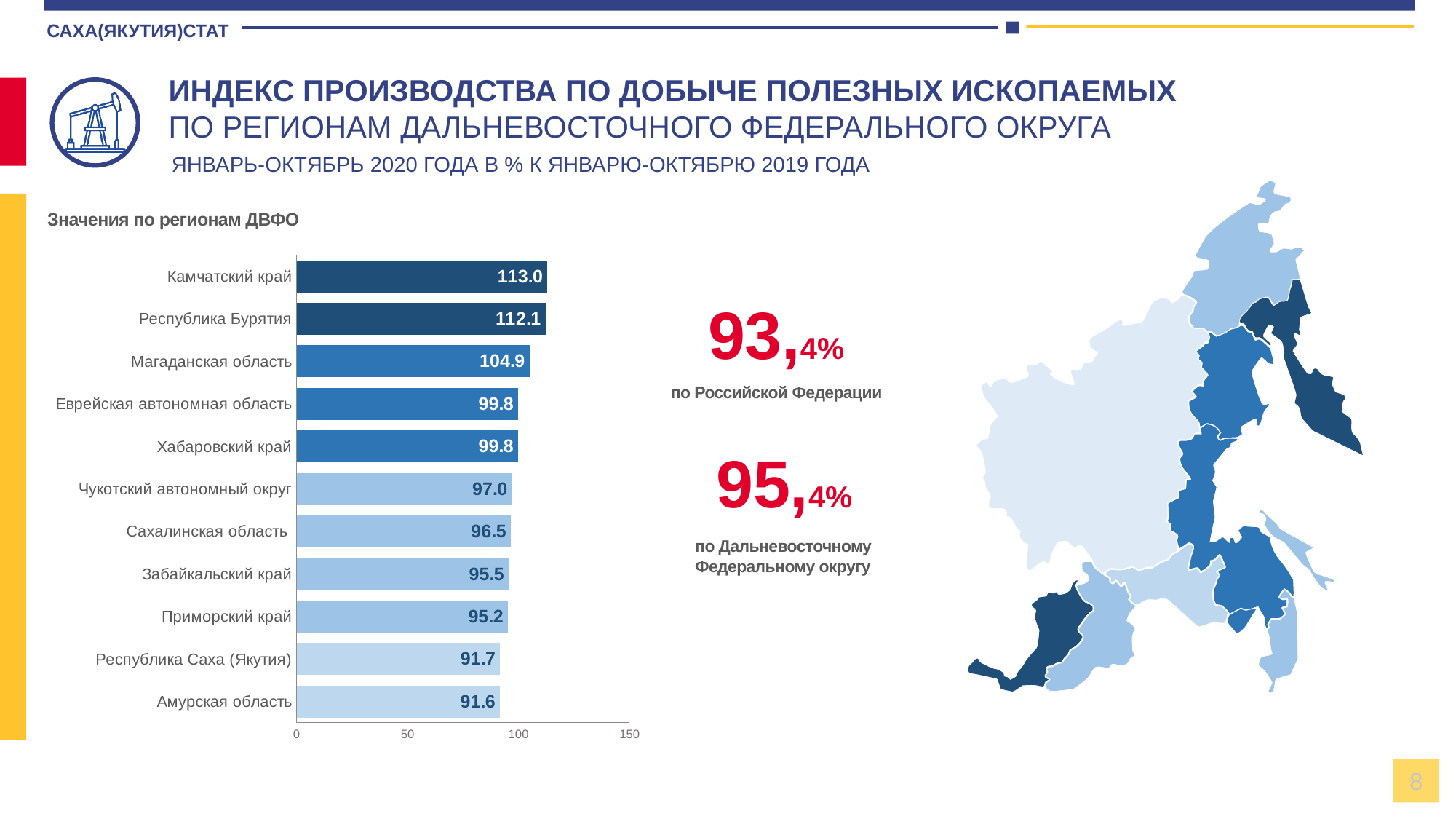
What is the value for Магаданская область? 104.9 Is the value for Республика Бурятия greater or less than 100? greater Which region has the lowest value in the chart? Амурская область What is the title shown above the bar chart? Значения по регионам ДВФО What kind of chart is used to show the values by region? bar chart Do the bar values increase or decrease going from the top of the chart to the bottom? decrease Which region has the highest value in the chart? Камчатский край What is the value for Камчатский край? 113.0 What is the difference between the values for Камчатский край and Амурская область? 21.4 What is the value for Республика Саха (Якутия)? 91.7 How many regions are shown in the bar chart? 11 Which is larger, the value for Магаданская область or the value for Чукотский автономный округ? Магаданская область